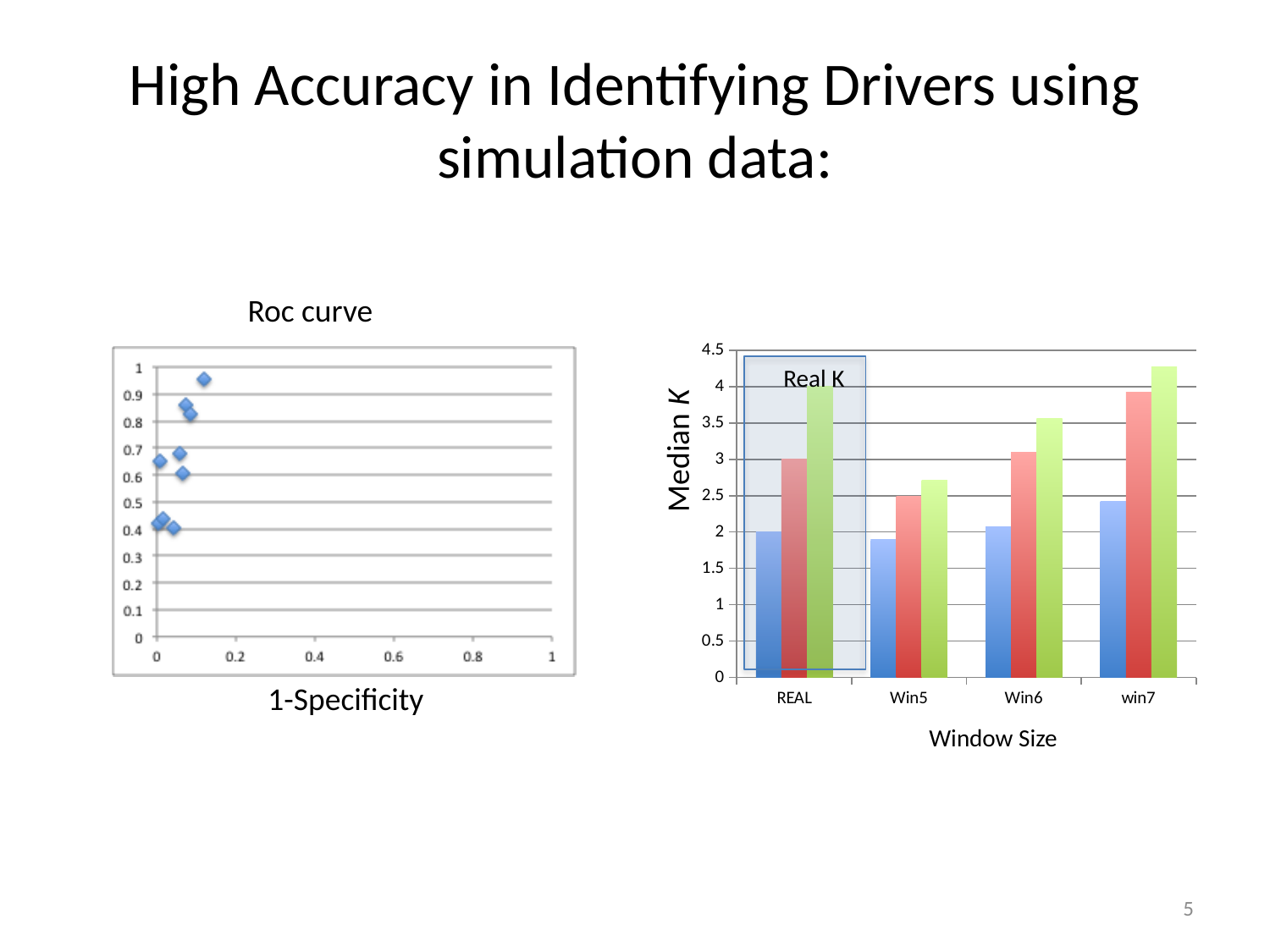
In the Window Size bar chart, how many bars are shown for each category? 3 In the Window Size bar chart, how many categories are shown on the x axis? 4 What is the x-axis label of the Roc curve chart? 1-Specificity What kind of chart is the right-hand chart with Window Size on the x axis? bar chart In the Window Size bar chart, which is larger: the red bar for Win6 or the red bar for Win5? Win6 In the Window Size bar chart, is the green bar for win7 greater or less than 4? greater In the Window Size bar chart, is the green bar for Win5 greater or less than 3? less In the Window Size bar chart, which category has the shortest blue bar? Win5 In the Window Size bar chart, do the green bars rise or fall from Win5 to win7? rise In the Window Size bar chart, which category has the tallest green bar? win7 In the Window Size bar chart, is the red bar for win7 greater or less than 3.5? greater What kind of chart is the Roc curve chart on the left? scatter plot